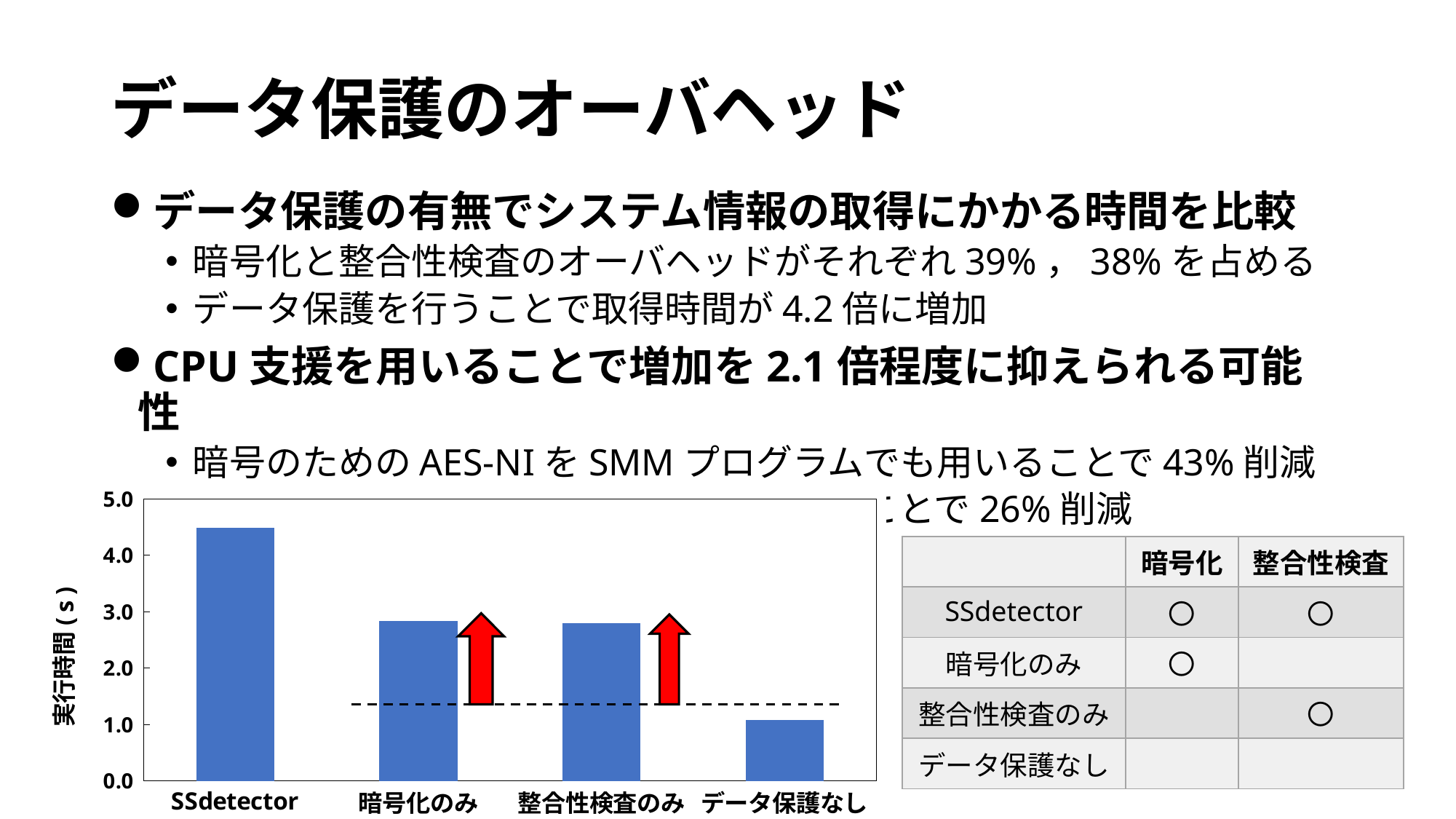
Which category has the lowest execution time in the chart? データ保護なし Which is larger, the value for 暗号化のみ or the value for データ保護なし? 暗号化のみ Is the value for データ保護なし greater or less than 2.0? less Which category has the highest execution time in the chart? SSdetector Which is larger, the value for SSdetector or the value for データ保護なし? SSdetector What kind of chart is shown on the slide? bar chart What is the label of the y axis of the chart? 実行時間 ( s ) What is the maximum value shown on the y axis of the chart? 5.0 How many categories are shown on the x axis of the chart? 4 Is the value for SSdetector greater or less than 4.0? greater Is the value for 暗号化のみ greater or less than 2.0? greater